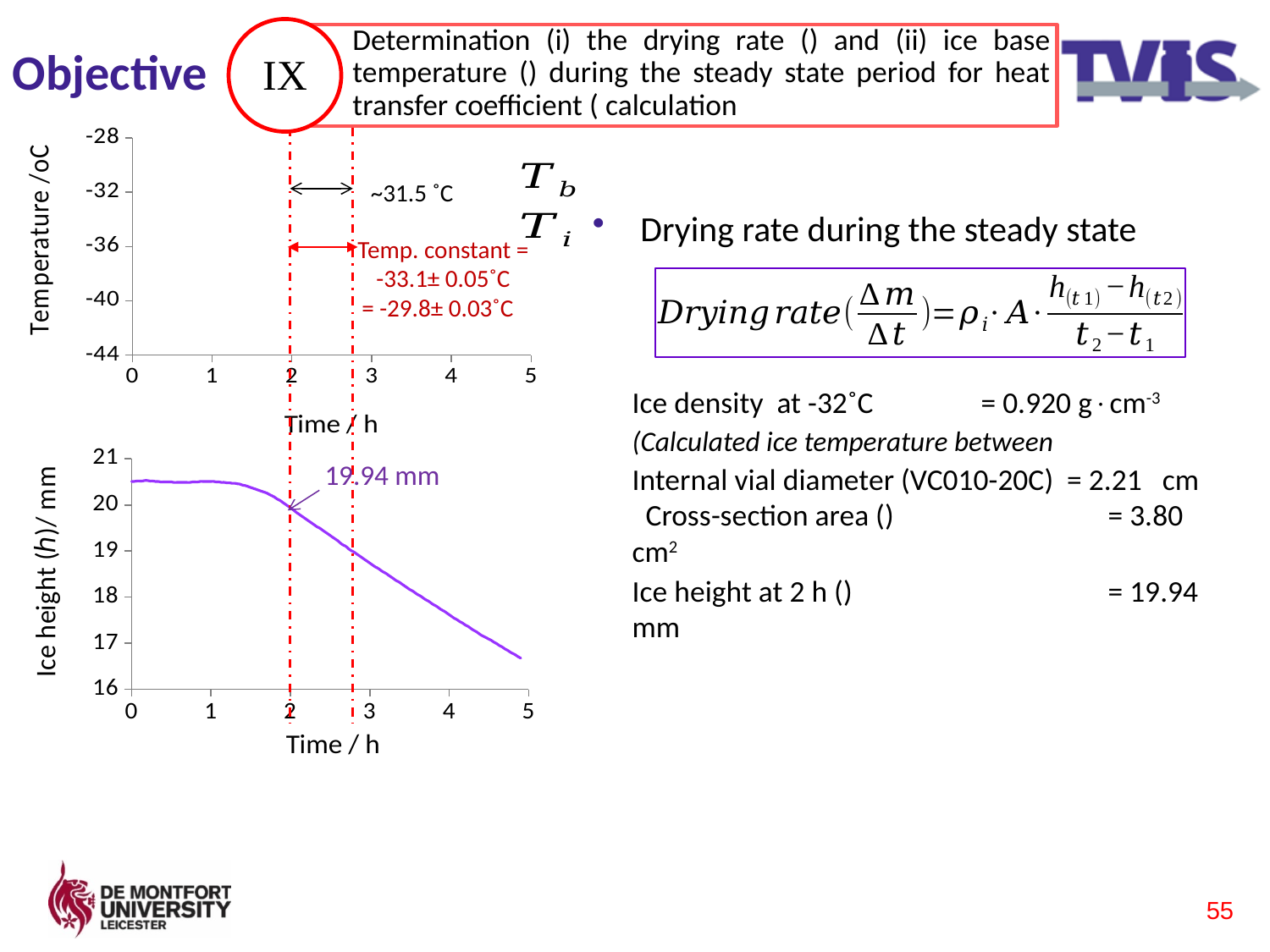
What kind of chart is the bottom chart (Ice height vs Time)? line chart What is the y-axis label of the top chart? Temperature /oC In the bottom chart, what is the ice height at 2 h according to the data label? 19.94 mm In the bottom chart, is the ice height at 4 h greater or less than 18 mm? less What is the y-axis label of the bottom chart? Ice height (h)/ mm In the bottom chart, which is larger: the ice height at 1 h or the ice height at 4 h? ice height at 1 h In the top chart, what is the lowest value shown on the temperature axis? -44 In the bottom chart, is the ice height at the end of the curve (near 5 h) greater or less than 17 mm? less In the bottom chart, what is the highest value shown on the x axis (Time / h)? 5 In the bottom chart, is the ice height at 1 h greater or less than 20 mm? greater In the bottom chart, does the ice height rise or fall as time increases from 2 h to 5 h? fall How many data series are plotted in the bottom chart? 1